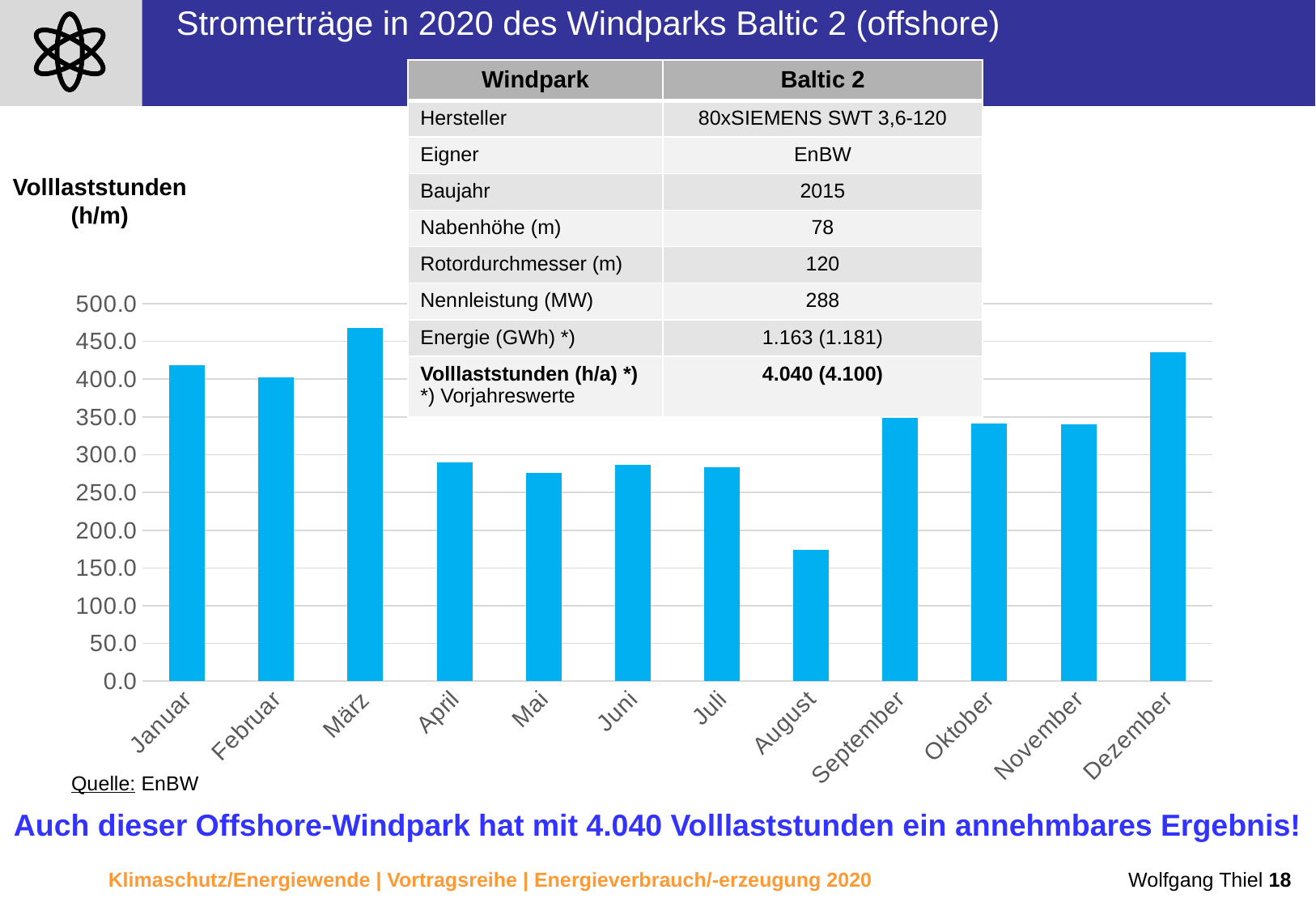
Which is larger, the value for August or the value for Mai? Mai What kind of chart is shown on the slide? bar chart Which month has the lowest Volllaststunden value in the chart? August Is the value for Mai greater or less than 300.0? less Which is larger, the value for März or the value for Dezember? März How many months are plotted on the x axis of the chart? 12 Is the value for August greater or less than 200.0? less Is the value for Dezember greater or less than 400.0? greater Which month has the highest Volllaststunden value in the chart? März What is the label of the y axis of the chart? Volllaststunden (h/m)